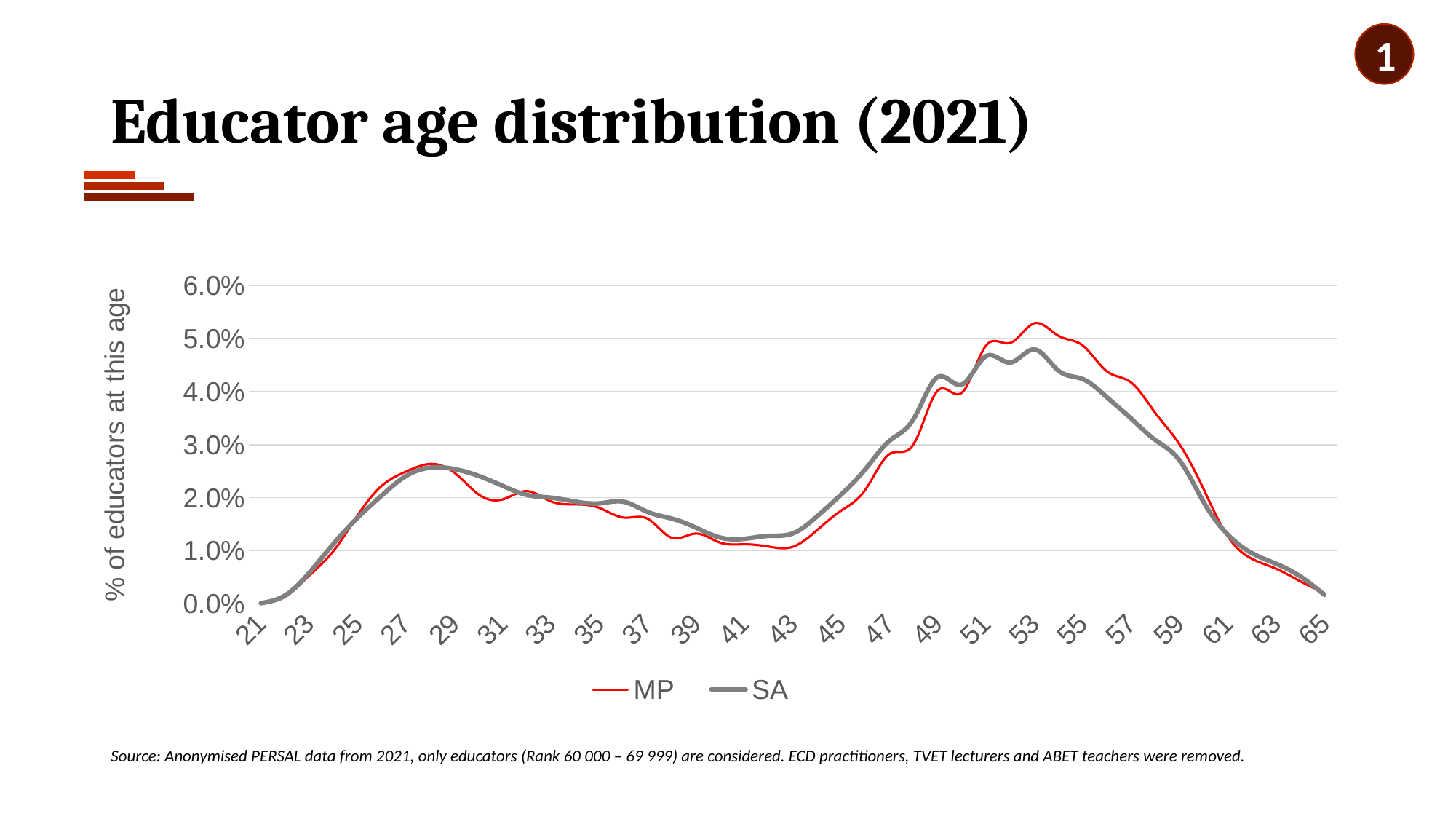
What are the two series named in the legend? MP and SA Is the value for MP at age 65 greater or less than 1.0%? less Which series reaches the higher peak value on the chart? MP At age 31, which series has the higher value, MP or SA? SA At age 57, which series has the higher value, MP or SA? MP How many series does the legend list? 2 Is the value for SA at age 53 greater or less than 5.0%? less What kind of chart is shown on the slide? Line chart Is the value for SA at age 29 greater or less than 2.0%? greater What is the label on the vertical axis? % of educators at this age